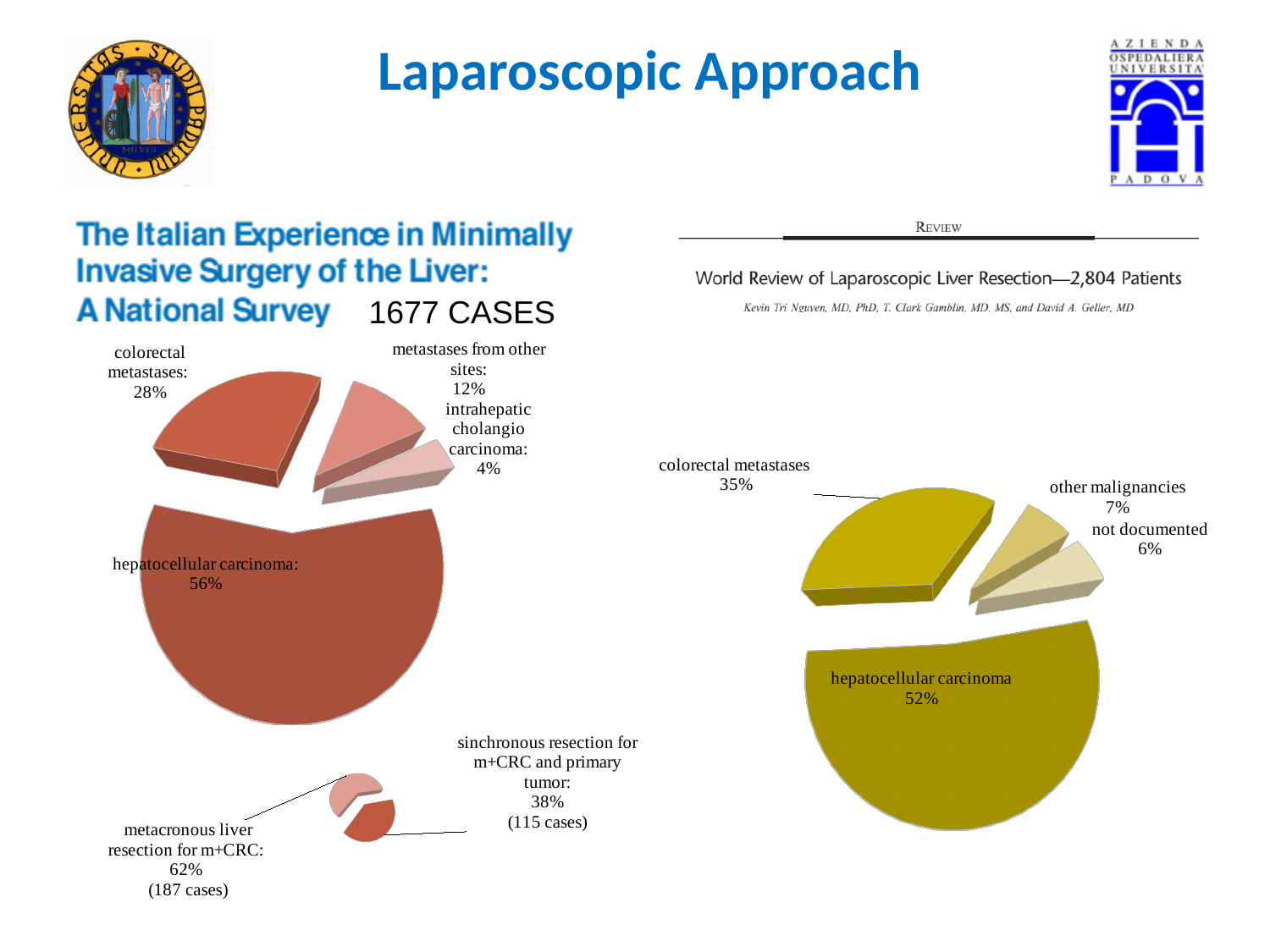
In the large pie chart on the left (Italian national survey), what share is colorectal metastases? 28% In the pie chart on the right (World Review of Laparoscopic Liver Resection), which is larger: other malignancies or not documented? other malignancies In the large pie chart on the left (Italian national survey, 1677 cases), what share is hepatocellular carcinoma? 56% In the small pie chart at the bottom left, what share is metachronous liver resection for m+CRC? 62% In the large pie chart on the left (Italian national survey), which category has the smallest share? intrahepatic cholangio carcinoma In the small pie chart at the bottom left, how many cases are shown for synchronous resection for m+CRC and primary tumor? 115 cases In the pie chart on the right (World Review of Laparoscopic Liver Resection), what is the combined share of other malignancies and not documented? 13% In the large pie chart on the left (Italian national survey), what is the difference in percentage points between hepatocellular carcinoma and colorectal metastases? 28 What type of chart is used for all three charts on the slide? pie chart In the pie chart on the right (World Review of Laparoscopic Liver Resection), which category has the largest share? hepatocellular carcinoma In the large pie chart on the left (Italian national survey), how many slices does the pie have? 4 In the pie chart on the right (World Review of Laparoscopic Liver Resection), what share is colorectal metastases? 35%